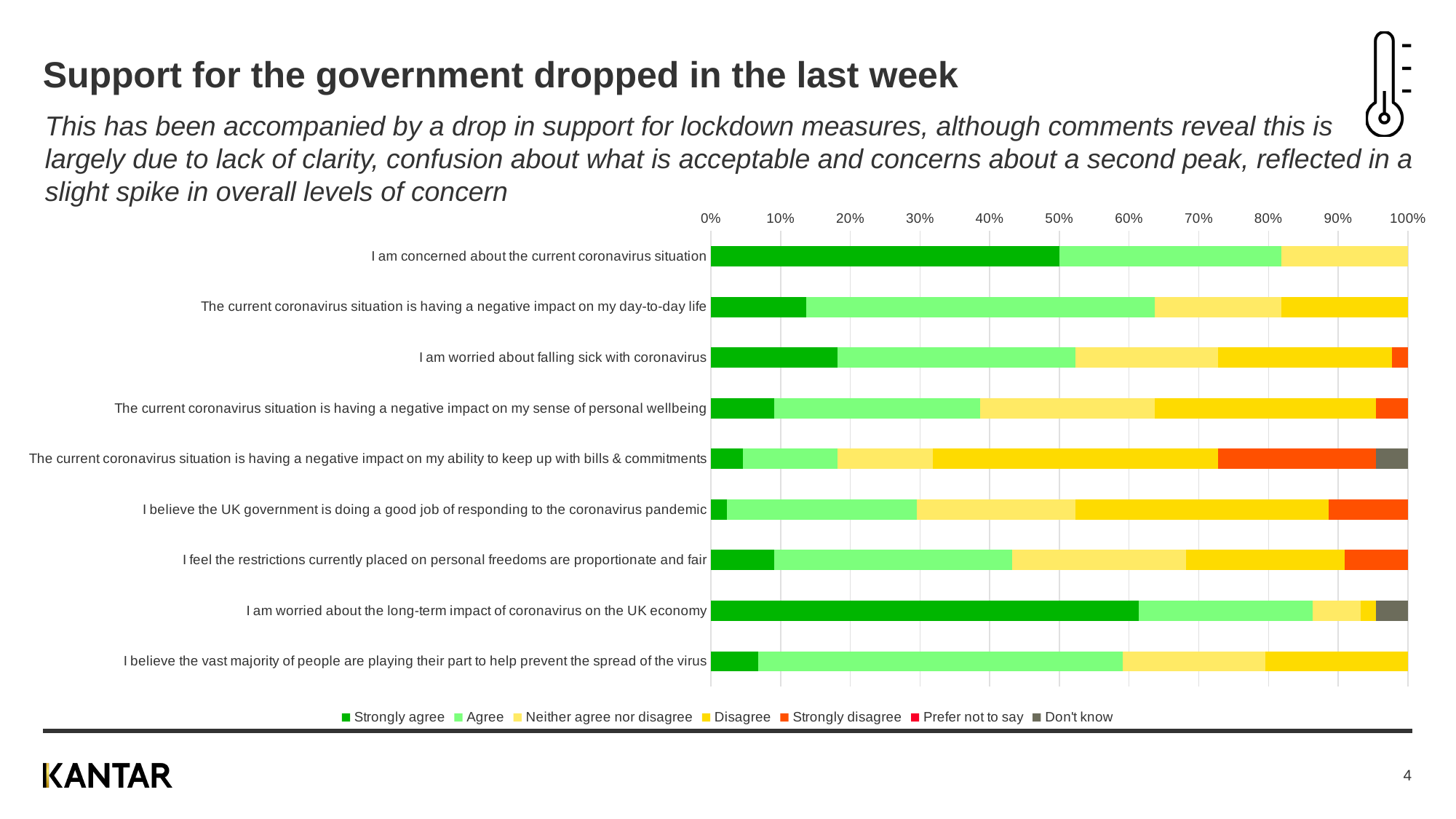
What colour represents 'Strongly disagree' in the legend? Orange What kind of chart is shown on the slide? Stacked bar chart Is the 'Strongly agree' value for 'I am concerned about the current coronavirus situation' greater or less than 40%? greater Which statement has the largest 'Strongly agree' segment? I am worried about the long-term impact of coronavirus on the UK economy Which statement has the smallest 'Strongly agree' segment? I believe the UK government is doing a good job of responding to the coronavirus pandemic Which has the larger 'Strongly agree' segment: 'I am concerned about the current coronavirus situation' or 'The current coronavirus situation is having a negative impact on my day-to-day life'? I am concerned about the current coronavirus situation Is the 'Strongly agree' value for 'The current coronavirus situation is having a negative impact on my day-to-day life' greater or less than 10%? greater How many statements (categories) are plotted in the chart? 9 How many series does the legend list? 7 Is the 'Strongly agree' value for 'I believe the UK government is doing a good job of responding to the coronavirus pandemic' greater or less than 10%? less What is the highest value shown on the percentage axis? 100%